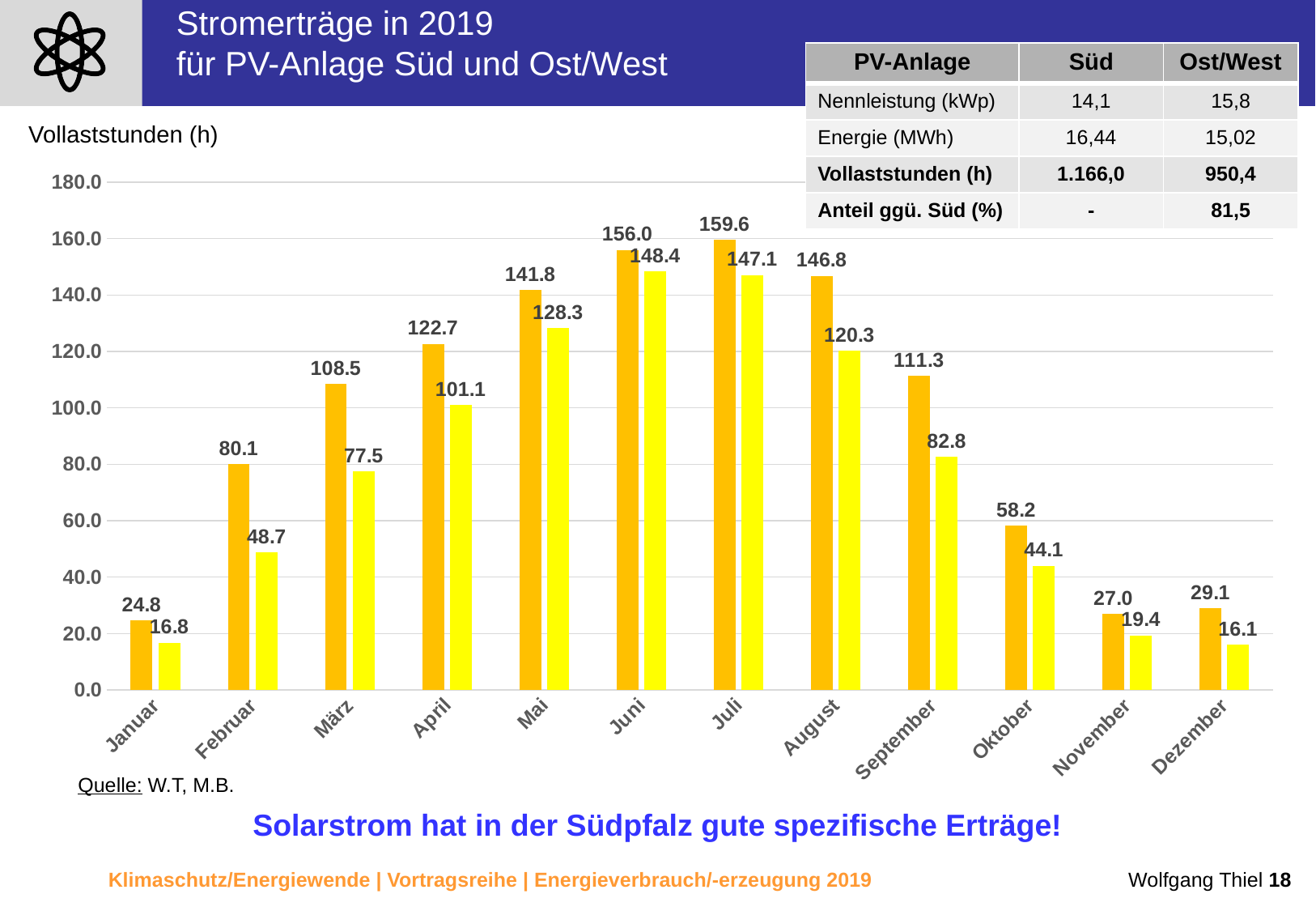
What is the difference between the orange and yellow bars for Juli? 12.5 Which month has the highest yellow bar? Juni Which is larger: the orange bar for November or the orange bar for Dezember? Dezember Which month has the lowest yellow bar? Dezember Which month has the highest orange bar? Juli What kind of chart is shown on the slide? Bar chart What is the value of the yellow bar for Oktober? 44.1 Do the orange bars rise or fall from Januar to Juli? Rise What is the value of the orange bar for Juli? 159.6 Which month has the lowest orange bar? Januar How many months are shown on the x axis? 12 What is the value of the yellow bar for April? 101.1